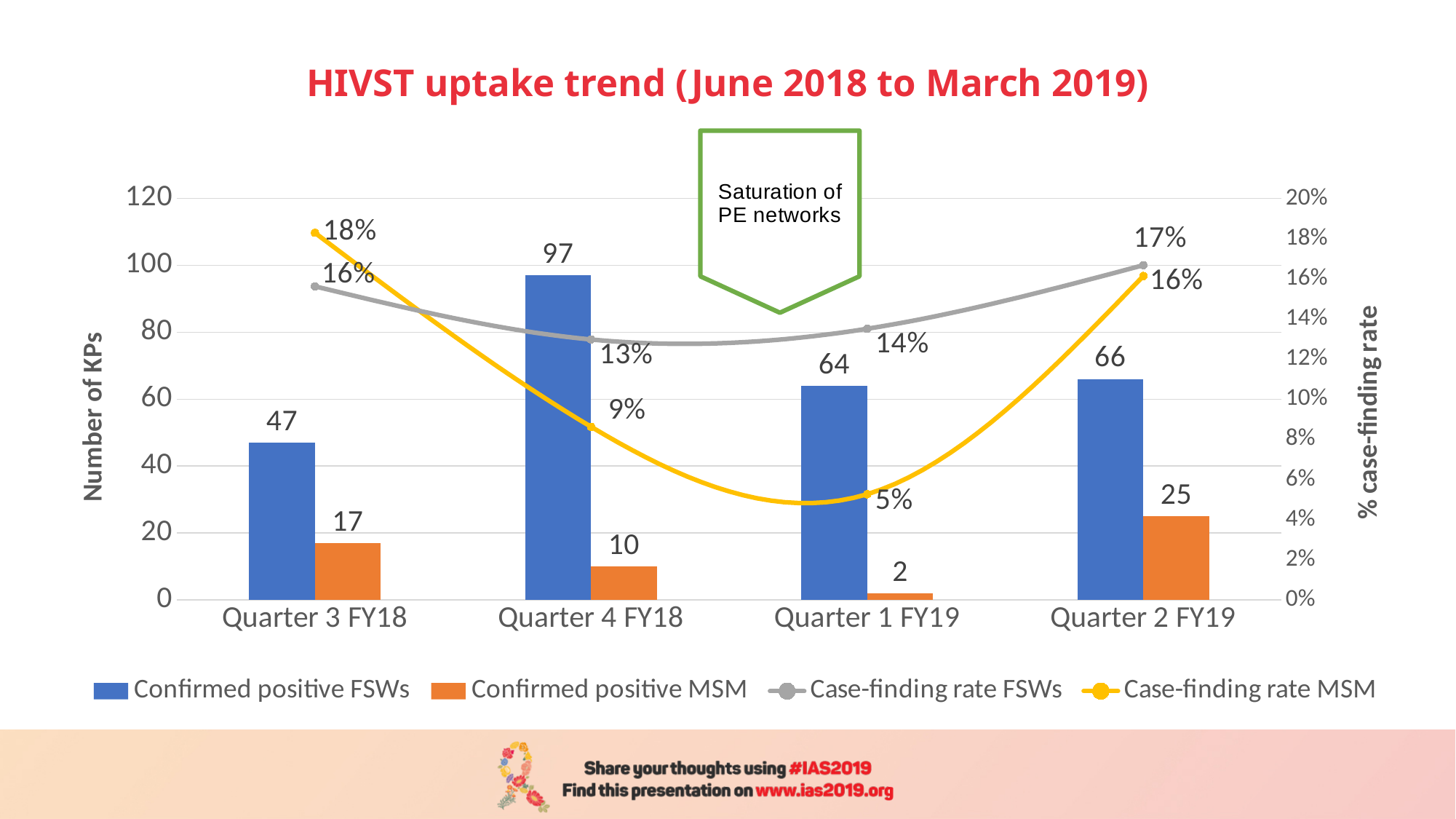
What kind of chart is this? Combined bar and line chart In which quarter is the number of confirmed positive FSWs highest? Quarter 4 FY18 What is the title of the chart? HIVST uptake trend (June 2018 to March 2019) Which is larger in Quarter 2 FY19: the case-finding rate for FSWs or for MSM? Case-finding rate FSWs What is the number of confirmed positive MSM in Quarter 2 FY19? 25 What is the case-finding rate for MSM in Quarter 1 FY19? 5% How many quarters are shown on the x axis? 4 In which quarter is the number of confirmed positive MSM lowest? Quarter 1 FY19 What is the number of confirmed positive FSWs in Quarter 4 FY18? 97 What is the difference between confirmed positive FSWs and confirmed positive MSM in Quarter 3 FY18? 30 How many series does the legend list? 4 What is the case-finding rate for FSWs in Quarter 3 FY18? 16%